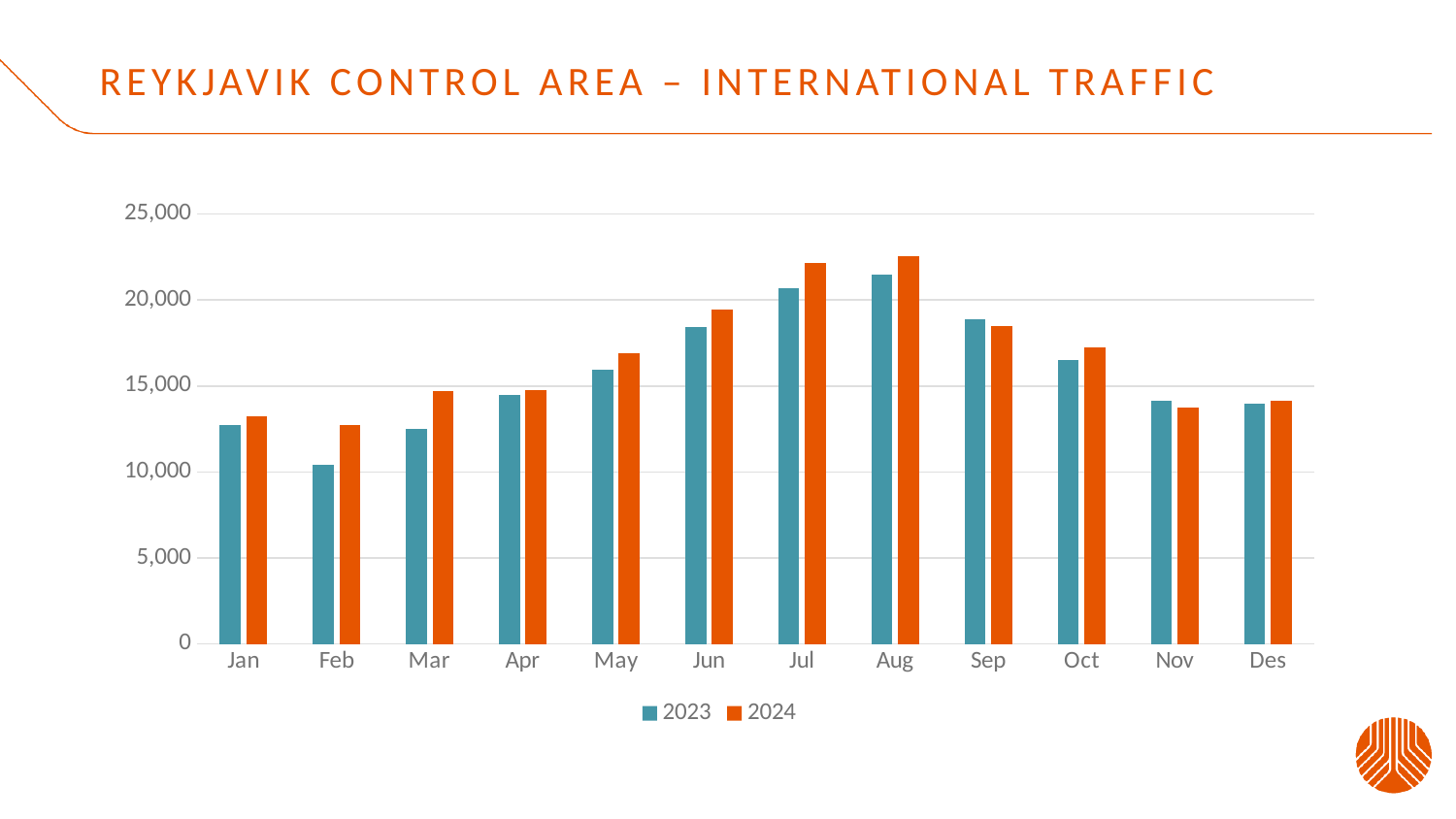
Which month has the lowest value for 2023? Feb Do the 2024 values rise or fall from Jan to Aug? rise (except a slight dip in Feb) Is the value for Jun 2023 greater or less than 20,000? less Which month has the highest value for 2024? Aug In Jul, which series has the larger value, 2023 or 2024? 2024 How many months are shown on the x axis? 12 What type of chart is shown on the slide? bar chart Which month has the highest value for 2023? Aug In Sep, which series has the larger value, 2023 or 2024? 2023 How many series does the legend list? 2 Is the value for Aug 2024 greater or less than 20,000? greater Is the value for Feb 2023 greater or less than 15,000? less